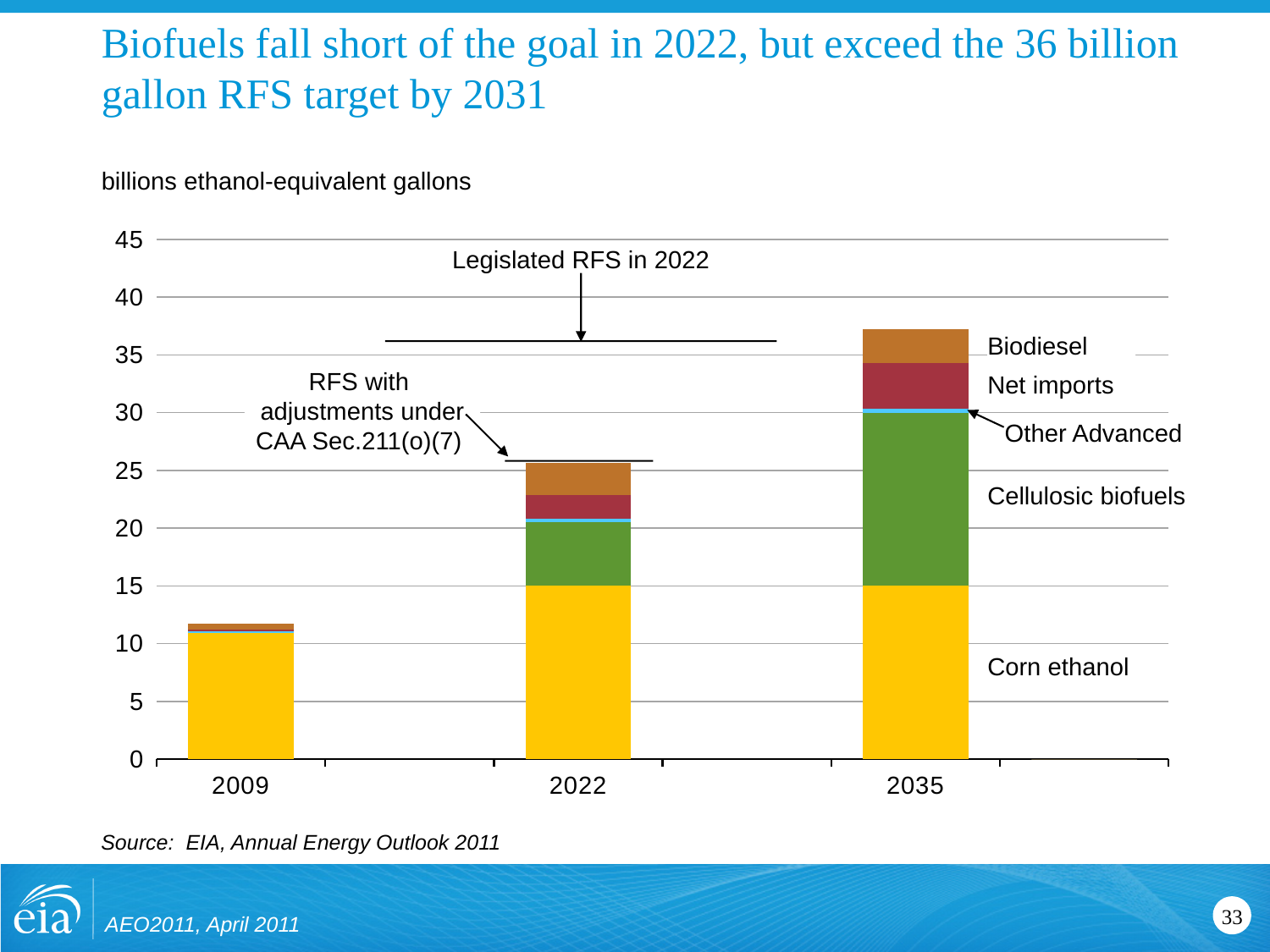
What kind of chart is shown on the slide? stacked bar chart Do the total biofuel volumes rise or fall from 2009 to 2035? rise What unit is given for the values in the chart? billions ethanol-equivalent gallons Is the total biofuel volume for 2035 greater or less than 35? greater Which year has the larger total biofuel volume, 2009 or 2022? 2022 Is the total biofuel volume for 2009 greater or less than 15? less How many years are shown on the x axis of the chart? 3 How many biofuel series are labelled in the chart? 5 Is the total biofuel volume for 2022 greater or less than 30? less Which year has the highest total biofuel volume? 2035 Which year has the lowest total biofuel volume? 2009 Which series forms the bottom segment of each stacked bar? Corn ethanol